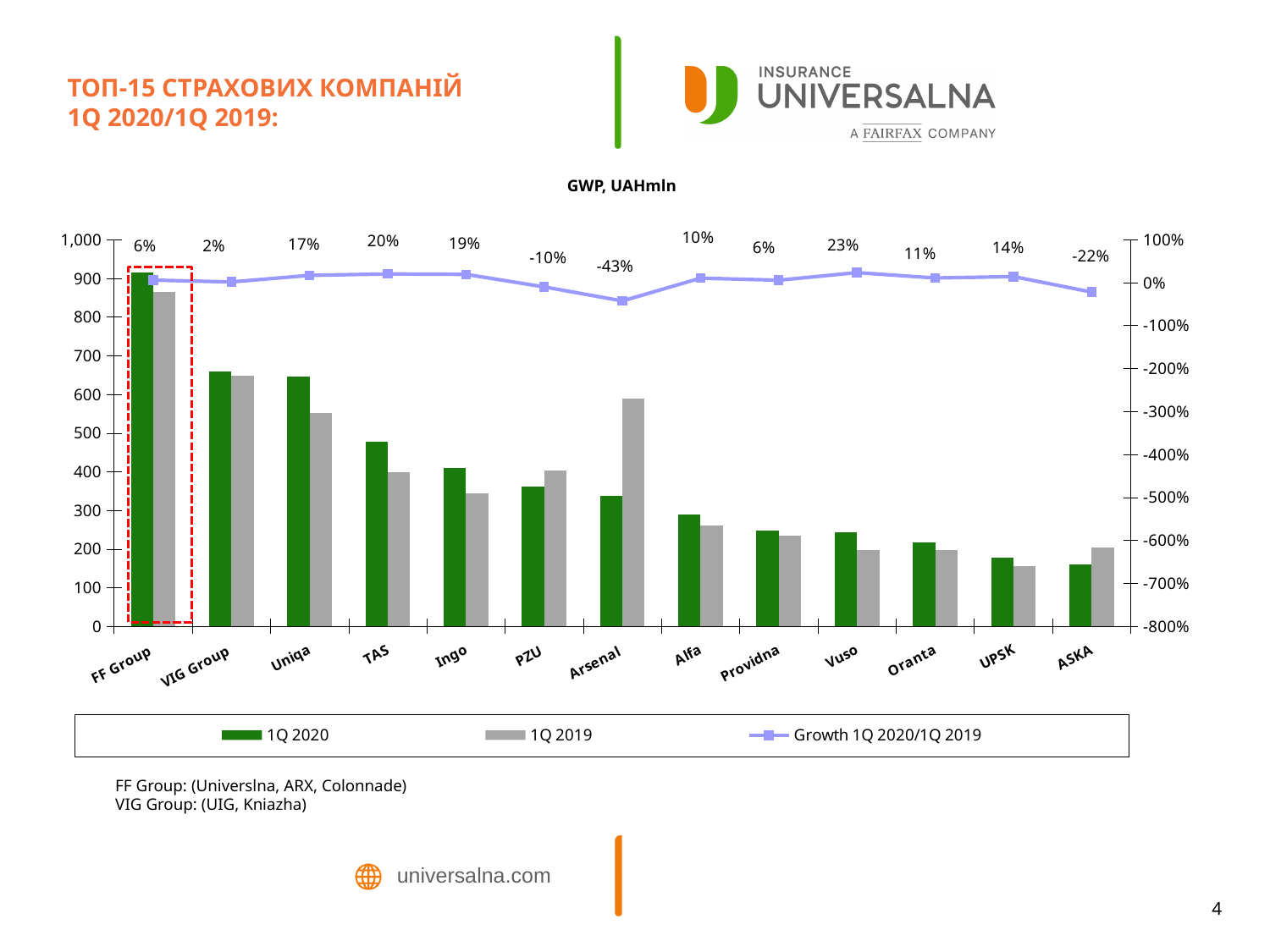
How many companies are shown on the x axis of the chart? 13 Which company has the lowest Growth 1Q 2020/1Q 2019 value? Arsenal Do the 1Q 2020 bars generally rise or fall from left to right along the x axis? fall For Arsenal, which bar is taller: 1Q 2020 or 1Q 2019? 1Q 2019 Is the 1Q 2020 value for TAS greater or less than 500? less What is the Growth 1Q 2020/1Q 2019 value shown for Arsenal? -43% How many series does the legend list? 3 What is the difference in percentage points between the growth values for Vuso and VIG Group? 21 percentage points What is the Growth 1Q 2020/1Q 2019 value shown for Vuso? 23% What is the Growth 1Q 2020/1Q 2019 value shown for TAS? 20% Is the 1Q 2020 value for Uniqa greater or less than 600? greater Which company has the highest Growth 1Q 2020/1Q 2019 value? Vuso